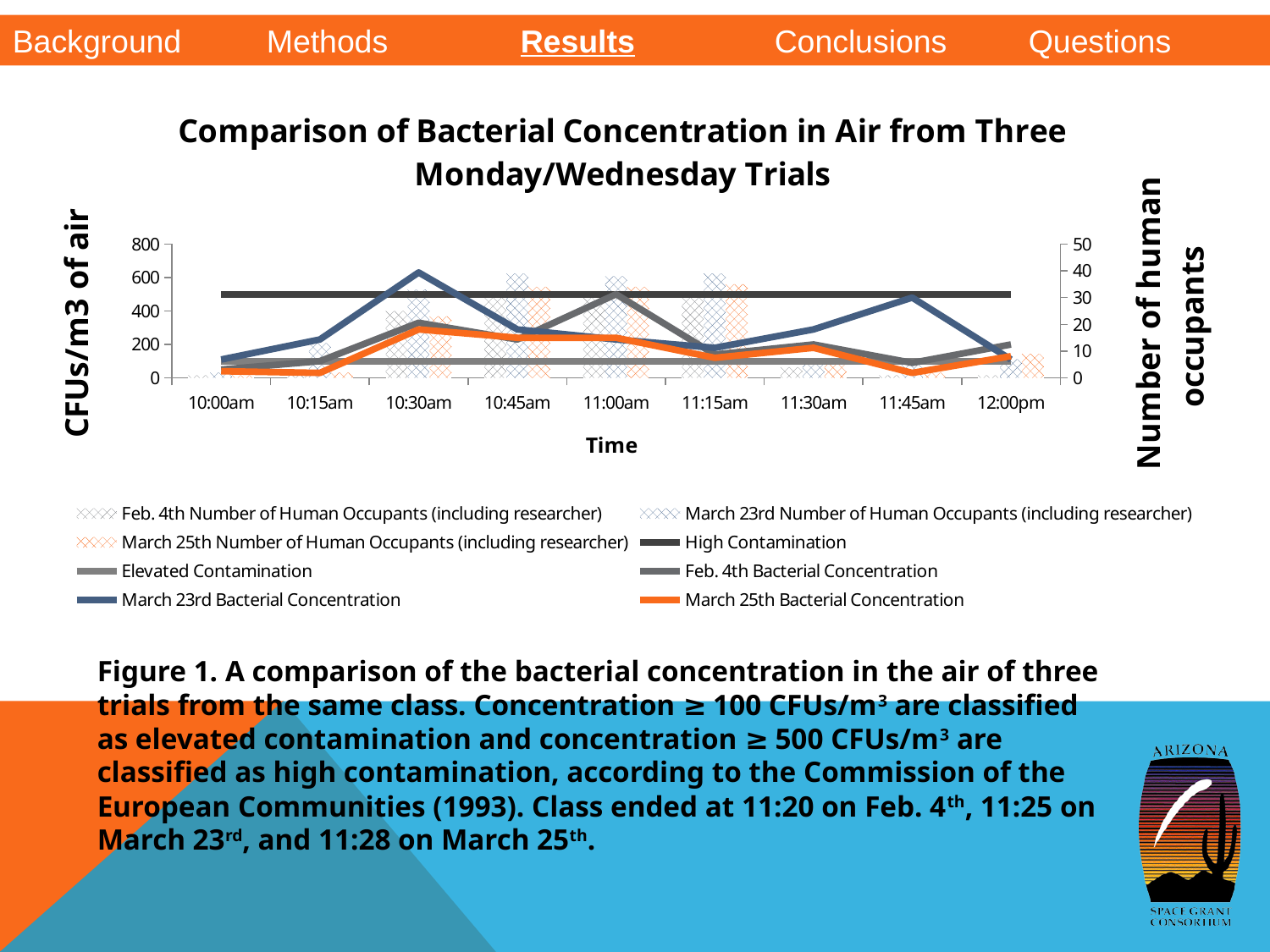
At which time is the March 23rd Bacterial Concentration highest? 10:30am How many time points are shown on the x axis of the chart? 9 Is the Feb. 4th Bacterial Concentration at 11:00am greater or less than 400? greater Is the March 25th Bacterial Concentration at 10:30am greater or less than 400? less At 10:30am, which is larger: the March 23rd Bacterial Concentration or the March 25th Bacterial Concentration? March 23rd Bacterial Concentration What kind of chart is shown on the slide? Combined line and bar chart What is the title of the chart? Comparison of Bacterial Concentration in Air from Three Monday/Wednesday Trials Does the March 23rd Bacterial Concentration rise or fall from 10:00am to 10:30am? rise Is the March 23rd Bacterial Concentration at 10:30am greater or less than 400? greater What is the label of the x axis of the chart? Time How many series does the chart legend list? 8